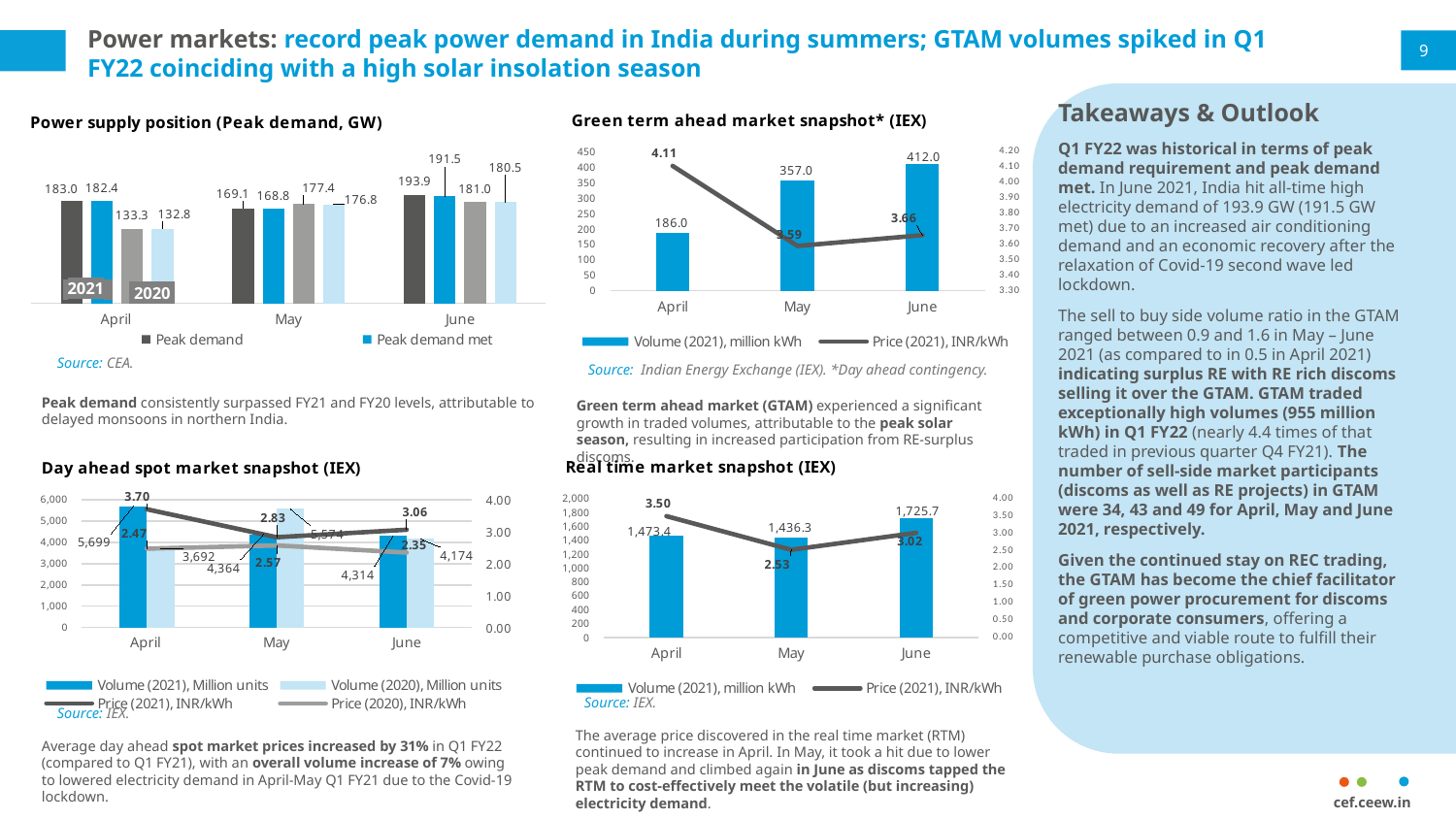
In the 'Day ahead spot market snapshot (IEX)' chart, what is the 2021 price for April? 3.70 In the 'Green term ahead market snapshot* (IEX)' chart, what is the difference between the June and April volumes? 226.0 What type of chart is the 'Power supply position (Peak demand, GW)' chart? bar chart In the 'Green term ahead market snapshot* (IEX)' chart, what is the volume for June? 412.0 In the 'Green term ahead market snapshot* (IEX)' chart, what is the price for April? 4.11 In the 'Real time market snapshot (IEX)' chart, which month has the lowest price? May In the 'Power supply position (Peak demand, GW)' chart, is the 2021 peak demand for April larger or smaller than the 2021 peak demand for May? larger In the 'Real time market snapshot (IEX)' chart, what is the volume for June? 1,725.7 In the 'Day ahead spot market snapshot (IEX)' chart, how many series does the legend list? 4 In the 'Real time market snapshot (IEX)' chart, how many months are shown on the x axis? 3 In the 'Green term ahead market snapshot* (IEX)' chart, which month has the lowest volume? April In the 'Power supply position (Peak demand, GW)' chart, what is the 2021 peak demand for June? 193.9